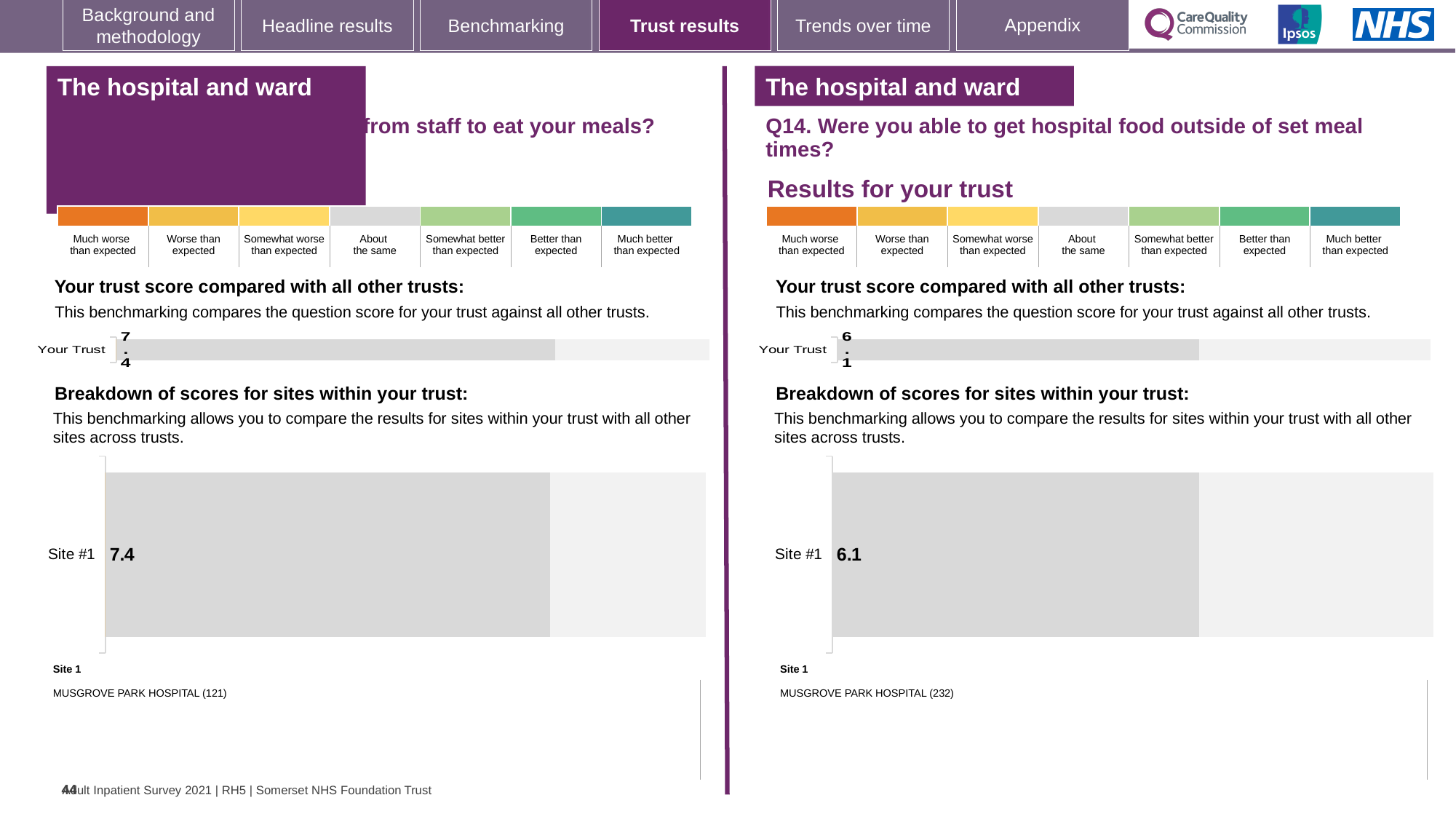
What type of chart is used to show the Site #1 score on the Q14 (right-hand) side? Bar chart How many sites are shown in the site breakdown chart on the Q14 (right-hand) side? 1 How many sites are shown in the site breakdown chart on the left-hand side? 1 On the left-hand chart, what is the score shown for Your Trust? 7.4 How many respondents are shown in brackets for Site 1 (MUSGROVE PARK HOSPITAL) on the left-hand side? 121 On the left-hand site breakdown chart, what is the score for Site #1? 7.4 What is the difference between the Site #1 score on the left-hand chart and the Site #1 score on the Q14 chart on the right? 1.3 On the Q14 site breakdown chart (right-hand side), what is the score for Site #1? 6.1 Is the Your Trust score on the Q14 (right-hand) chart greater or less than 7? less Which is larger: the Your Trust score on the left-hand chart or the Your Trust score on the Q14 chart on the right? The left-hand chart (7.4) On the Q14 chart (right-hand side), what is the score shown for Your Trust? 6.1 Which hospital is listed as Site 1 on the Q14 (right-hand) side, and how many respondents are shown in brackets? MUSGROVE PARK HOSPITAL (232)